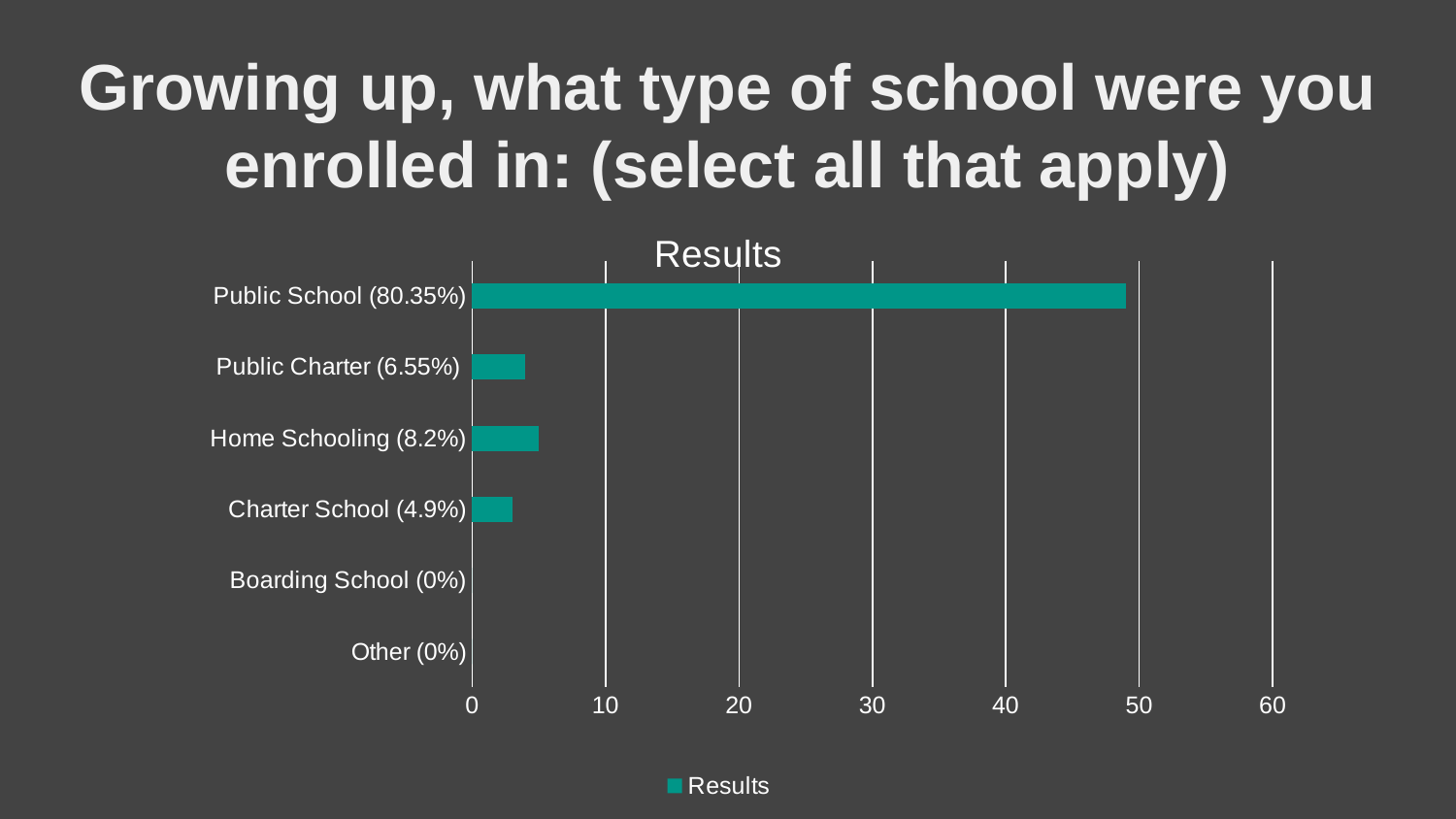
How many categories are shown on the chart? 6 What percentage is shown in the category label for Public School? 80.35% Which category has the highest value? Public School (80.35%) Which is larger, the value for Public School or the value for Public Charter? Public School Is the value for Charter School greater or less than 10? less How many series does the legend list? 1 Is the value for Public School greater or less than 40? greater Which is larger, the value for Home Schooling or the value for Charter School? Home Schooling What is the title of the chart? Results Is the value for Public School greater or less than 50? less What kind of chart is shown on the slide? bar chart